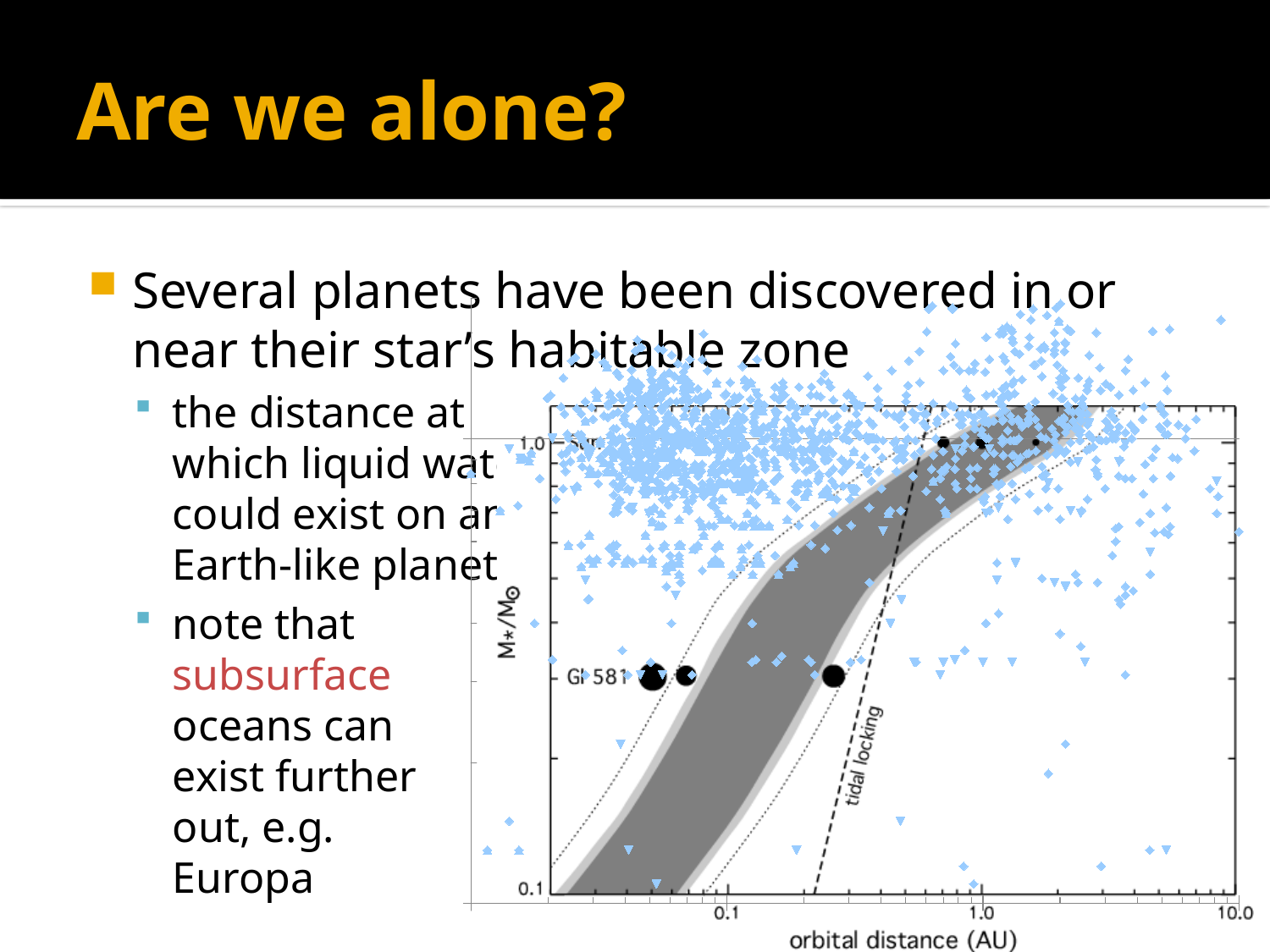
What is the label of the y axis of the chart? M*/M☉ As stellar mass increases along the y axis, does the grey habitable-zone band move to larger or smaller orbital distances? larger Is the stellar mass (M*/M☉) of Gl 581 on the chart greater or less than 1.0? less What is the smallest stellar mass tick shown on the y axis of the chart? 0.1 What is the largest orbital distance tick shown on the x axis of the chart? 10.0 Is the stellar mass (M*/M☉) of Gl 581 on the chart greater or less than 0.1? greater What kind of chart is shown on the slide? scatter plot What stellar mass (M*/M☉) is the Sun plotted at on the chart? 1.0 What is the label of the x axis of the chart? orbital distance (AU) Which of the two labelled stars on the chart, the Sun or Gl 581, has the larger stellar mass? Sun Is the orbital distance of the leftmost Gl 581 planet on the chart greater or less than 0.1 AU? less